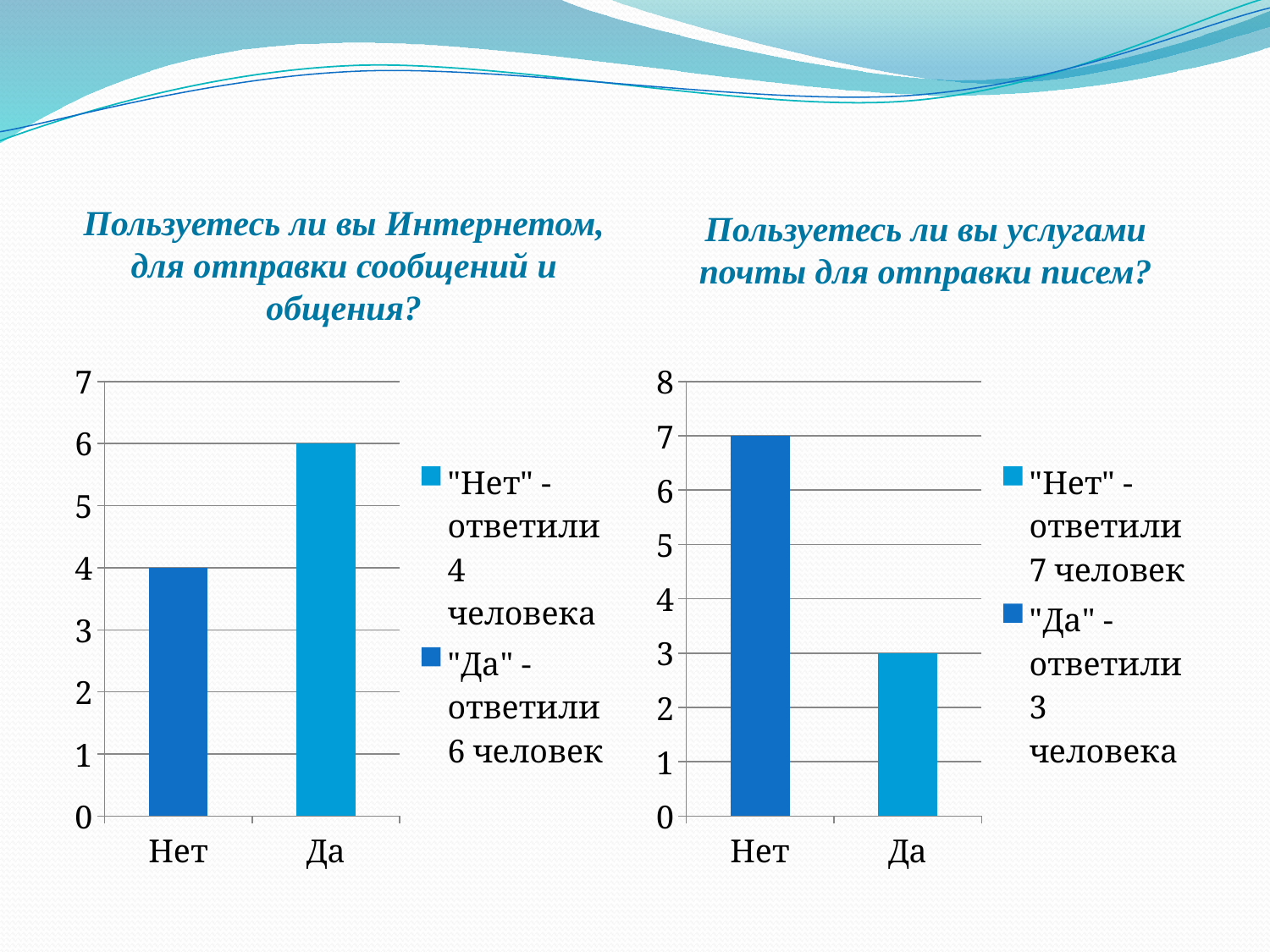
In the left chart (Пользуетесь ли вы Интернетом, для отправки сообщений и общения?), how many people answered "Да"? 6 How many categories are shown on the x axis of the left chart (Пользуетесь ли вы Интернетом, для отправки сообщений и общения?)? 2 In the left chart (Пользуетесь ли вы Интернетом, для отправки сообщений и общения?), which answer has the taller bar? Да In the right chart (Пользуетесь ли вы услугами почты для отправки писем?), how many people answered "Да"? 3 Is the "Нет" value in the right chart (Пользуетесь ли вы услугами почты для отправки писем?) larger than the "Нет" value in the left chart? Yes In the left chart (Пользуетесь ли вы Интернетом, для отправки сообщений и общения?), what is the difference between the "Да" and "Нет" counts? 2 In the right chart (Пользуетесь ли вы услугами почты для отправки писем?), which answer has the shorter bar? Да In the right chart (Пользуетесь ли вы услугами почты для отправки писем?), how many people answered "Нет"? 7 In the left chart (Пользуетесь ли вы Интернетом, для отправки сообщений и общения?), how many people answered "Нет"? 4 What type of chart is the right chart (Пользуетесь ли вы услугами почты для отправки писем?)? Bar chart How many entries does the legend of the right chart (Пользуетесь ли вы услугами почты для отправки писем?) list? 2 In the right chart (Пользуетесь ли вы услугами почты для отправки писем?), what is the difference between the "Нет" and "Да" counts? 4